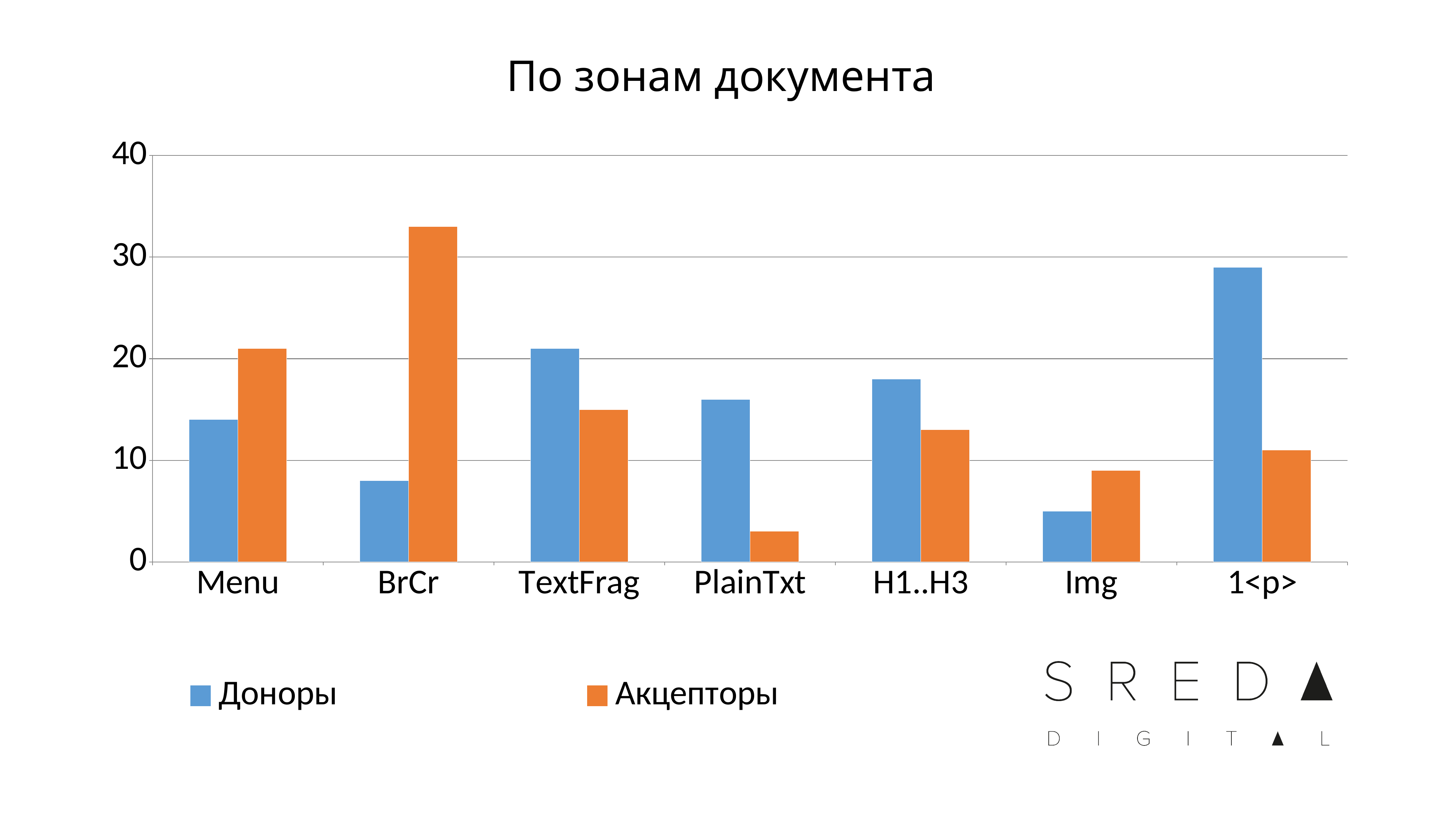
For PlainTxt, which series has the larger value, Доноры or Акцепторы? Доноры Which category has the lowest value for Акцепторы? PlainTxt Which category has the lowest value for Доноры? Img Which category has the highest value for Акцепторы? BrCr Which category has the highest value for Доноры? 1<p> For BrCr, which series has the larger value, Доноры or Акцепторы? Акцепторы Is the value for Доноры at Img greater or less than 10? less Is the value for Акцепторы at BrCr greater or less than 30? greater What is the title of the chart? По зонам документа How many categories are shown on the x axis? 7 What kind of chart is shown on the slide? bar chart How many series does the legend list? 2